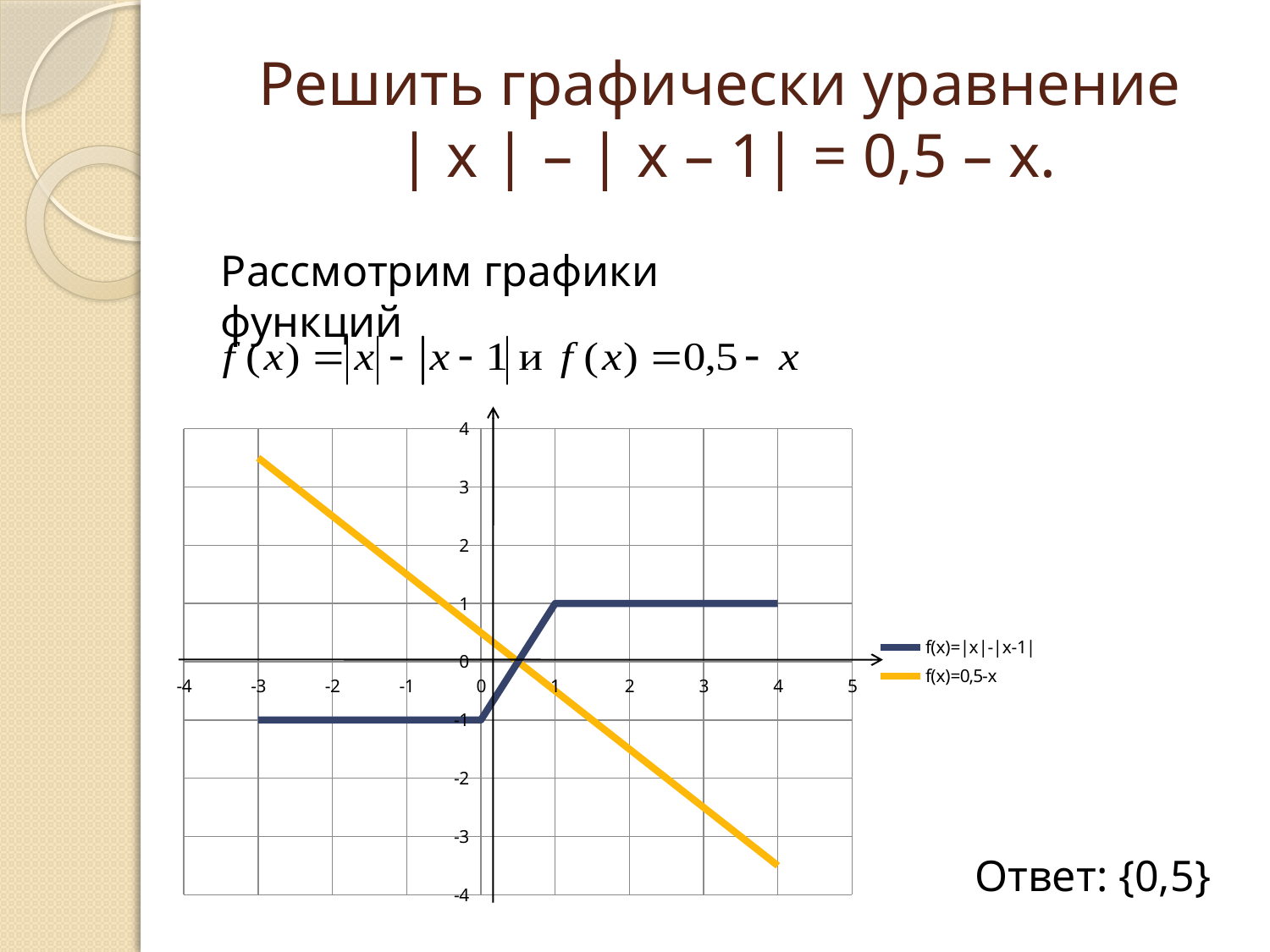
What is the highest value reached by the f(x)=|x|-|x-1| line? 1 What is the lowest value reached by the f(x)=|x|-|x-1| line? -1 What colour is the f(x)=0,5-x line in the chart? yellow What is the value of f(x)=|x|-|x-1| at x = -2? -1 How many series does the legend list? 2 Does the f(x)=0,5-x line rise or fall as x increases? fall What is the value of f(x)=|x|-|x-1| at x = 3? 1 What kind of chart is shown on the slide? line chart At x = -2, which line is higher: f(x)=|x|-|x-1| or f(x)=0,5-x? f(x)=0,5-x Is the value of f(x)=0,5-x at x = -3 greater or less than 3? greater At x = 3, which line is higher: f(x)=|x|-|x-1| or f(x)=0,5-x? f(x)=|x|-|x-1| Is the value of f(x)=0,5-x at x = 4 greater or less than -3? less